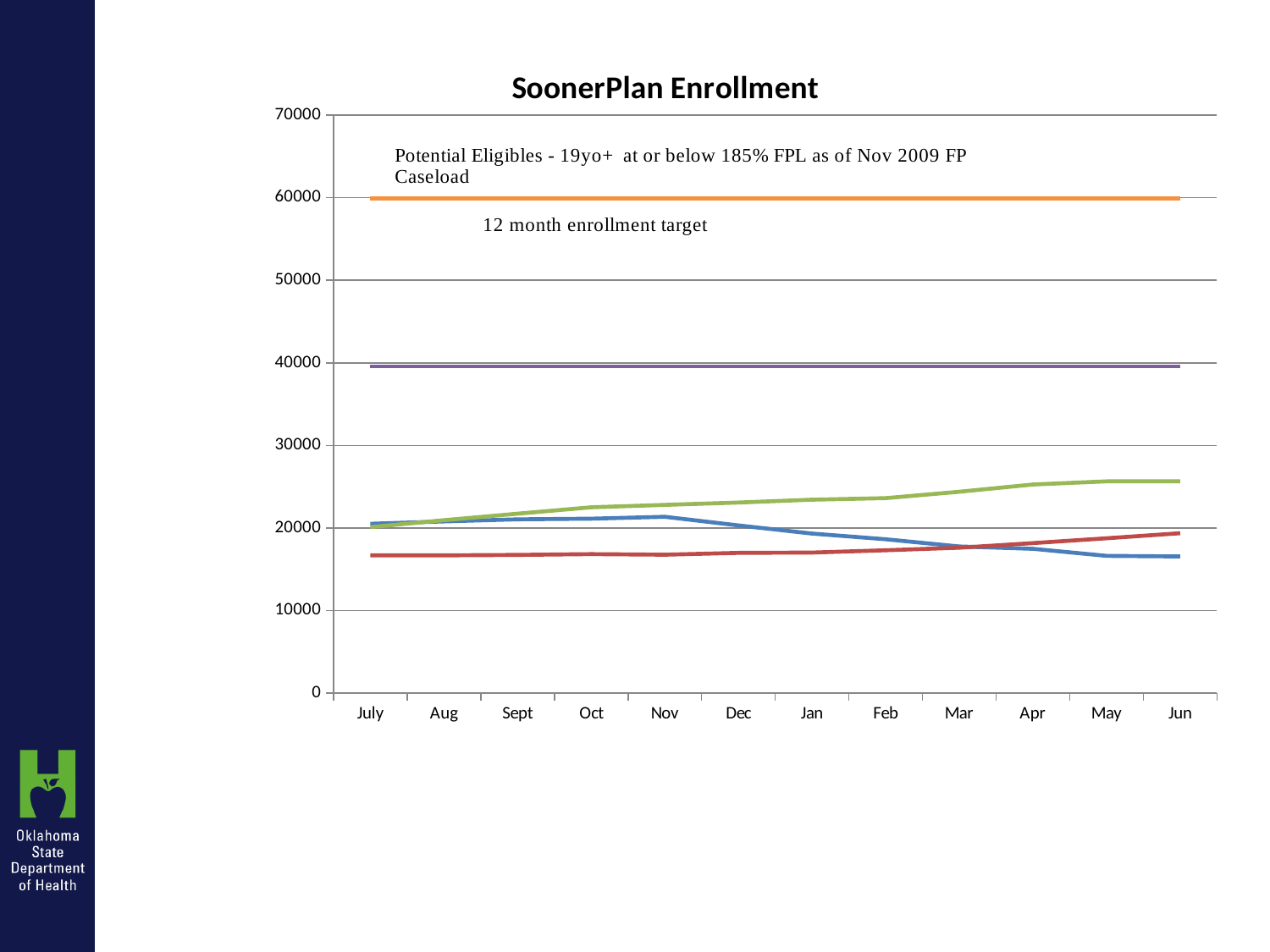
Is the value of the green line in Jun greater or less than 20000? greater How many months are shown along the x axis of the SoonerPlan Enrollment chart? 12 What is the title of the chart? SoonerPlan Enrollment Is the value of the Potential Eligibles line greater or less than 50000? greater Does the blue line rise or fall from Nov to Jun? falls What colour is the line labeled "12 month enrollment target"? purple Is the value of the blue line in Jun greater or less than 20000? less What kind of chart is shown on the slide? line chart Does the green line rise or fall from July to Jun? rises In Jun, which is higher, the green line or the blue line? the green line